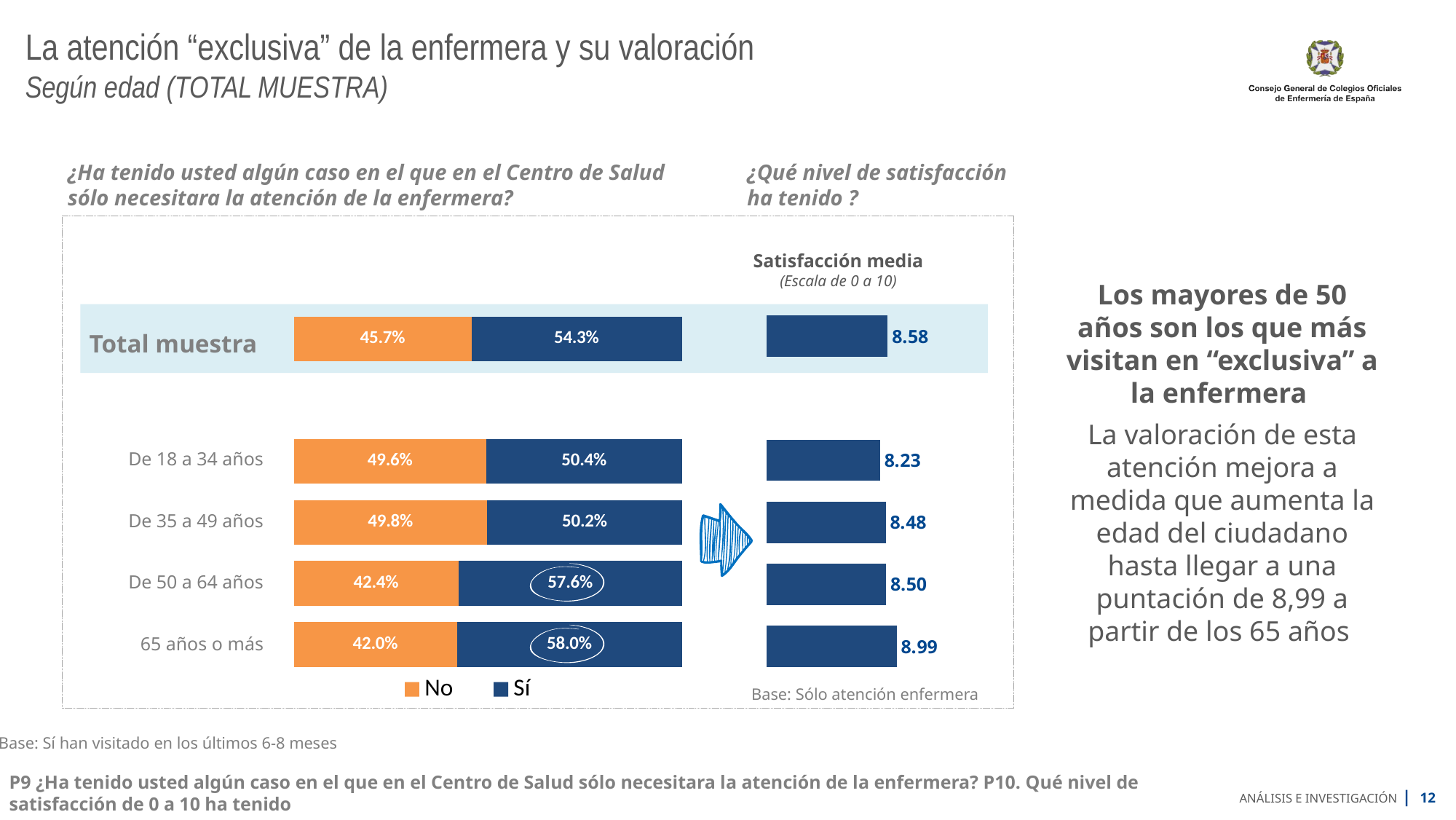
In the stacked bar chart, what percentage of the 'De 18 a 34 años' group answered 'No'? 49.6% In the stacked bar chart, what is the difference between the 'Sí' and 'No' percentages for 'Total muestra'? 8.6 percentage points In the 'Satisfacción media' bar chart, which age group has the lowest value? De 18 a 34 años In the 'Satisfacción media' bar chart, what is the difference between the values for '65 años o más' and 'De 18 a 34 años'? 0.76 In the 'Satisfacción media' bar chart, what is the value for 'De 35 a 49 años'? 8.48 In the stacked bar chart, which has a larger 'Sí' percentage: 'De 50 a 64 años' or 'De 35 a 49 años'? De 50 a 64 años What kind of chart is used to show the 'No' and 'Sí' percentages? Stacked bar chart How many series does the legend of the stacked bar chart list? 2 In the stacked bar chart, what percentage of the '65 años o más' group answered 'Sí'? 58.0% In the 'Satisfacción media' bar chart, do the values rise or fall from 'De 18 a 34 años' to '65 años o más'? Rise In the 'Satisfacción media' bar chart, which age group has the highest value? 65 años o más In the stacked bar chart, how many age groups are shown below 'Total muestra'? 4